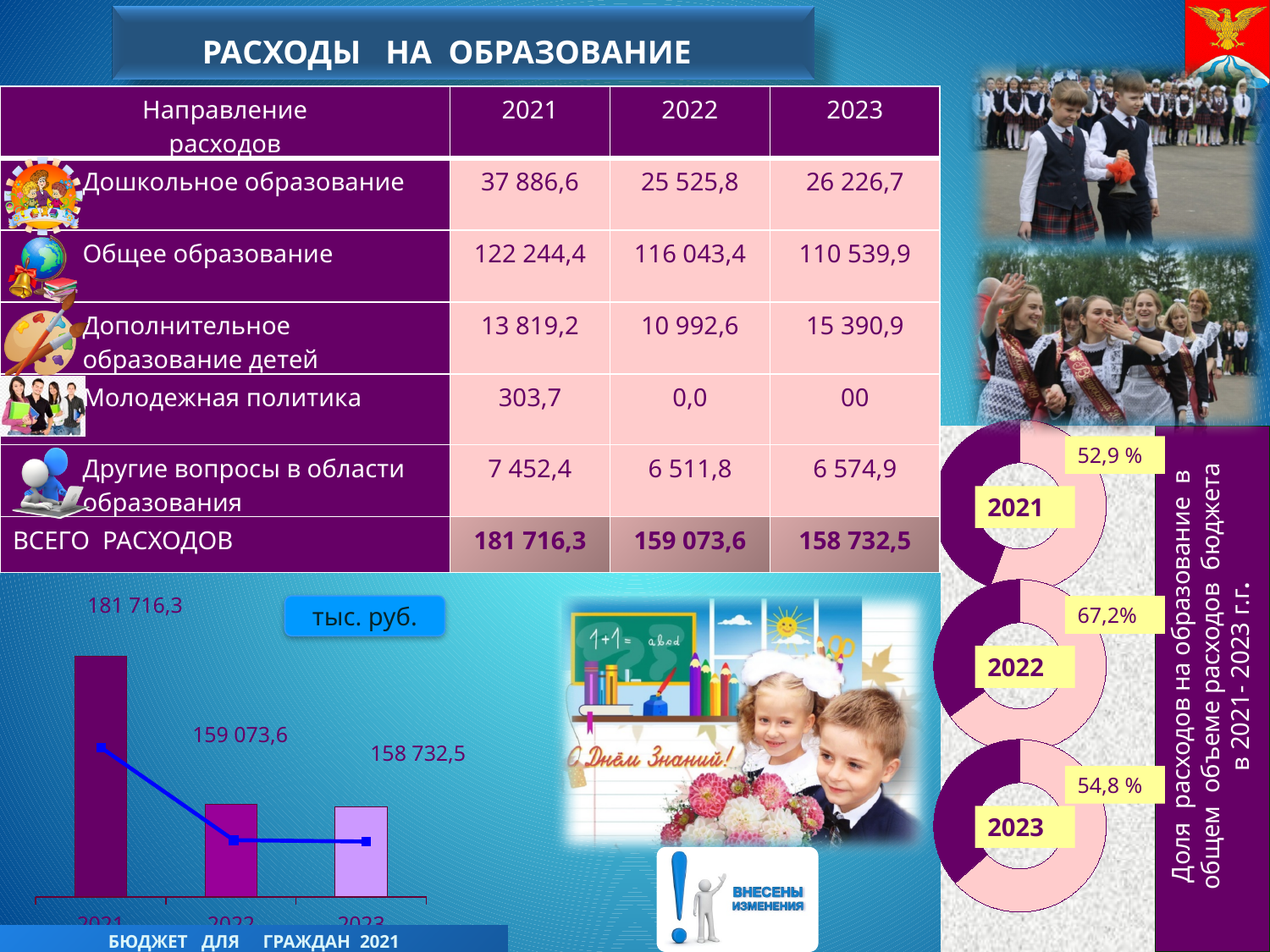
On the bar chart at the bottom left, do the values rise or fall from 2021 to 2023? fall On the bar chart at the bottom left, is the value for 2021 larger or smaller than the value for 2023? larger How many years are shown on the bar chart at the bottom left? 3 On the donut charts on the right, what share is shown for 2022? 67,2% What kind of chart is shown at the bottom left of the slide? bar chart On the bar chart at the bottom left, what is the difference between the values for 2021 and 2022? 22 642,7 On the bar chart at the bottom left, which year has the lowest value? 2023 On the bar chart at the bottom left, what is the value for 2023? 158 732,5 On the donut charts on the right, which year has the lowest share? 2021 On the bar chart at the bottom left, what is the value for 2022? 159 073,6 On the bar chart at the bottom left, what is the value for 2021? 181 716,3 On the bar chart at the bottom left, which year has the highest value? 2021